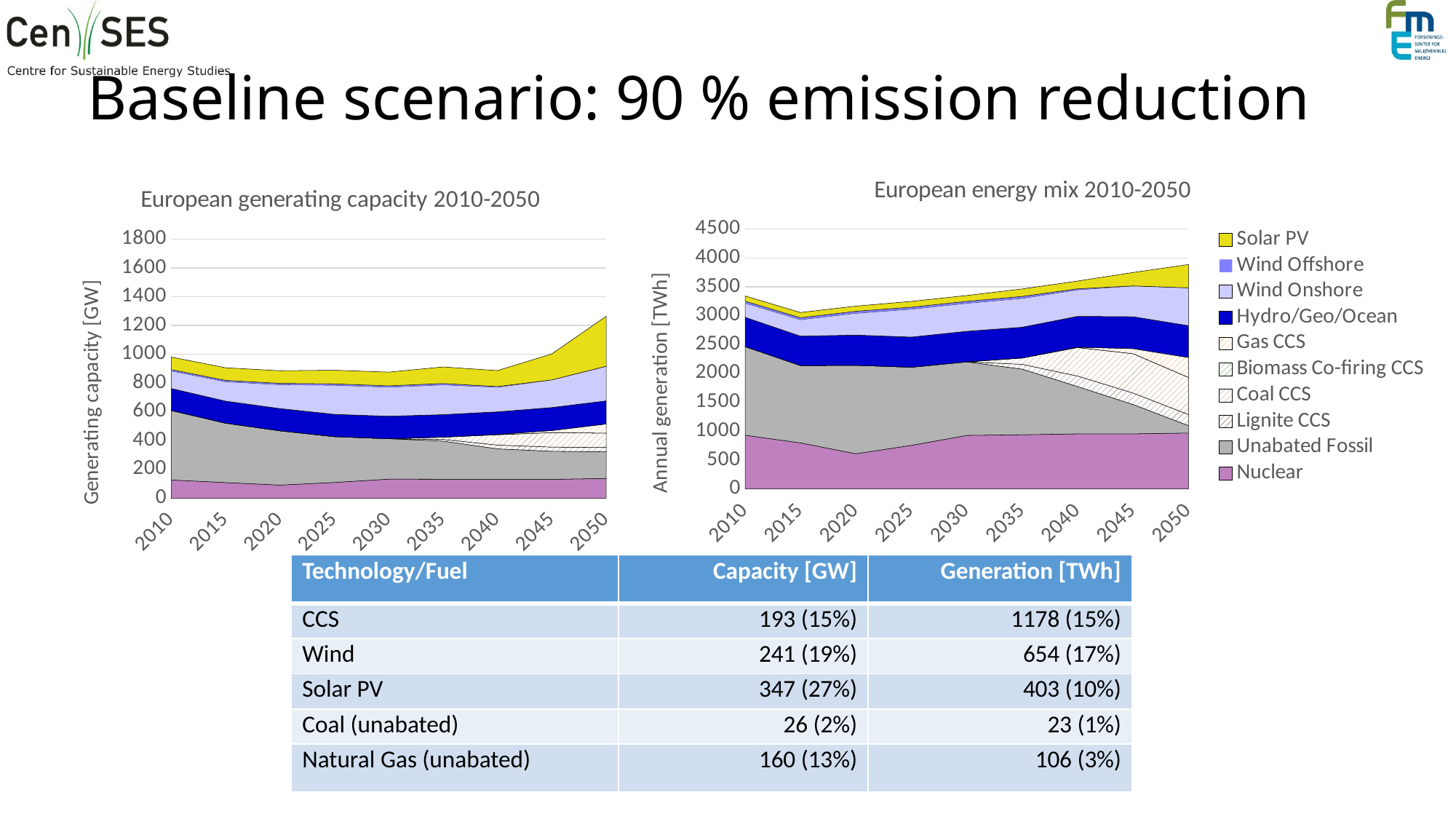
What kind of chart is the 'European generating capacity 2010-2050' chart? Stacked area chart In the 'European energy mix 2010-2050' chart, is the Nuclear generation in 2020 greater or less than 1000 TWh? less In the 'European generating capacity 2010-2050' chart, is the total capacity in 2050 greater or less than 1000 GW? greater Which colour represents Solar PV in the legend? Yellow In the 'European energy mix 2010-2050' chart, does the Unabated Fossil generation rise or fall between 2030 and 2050? fall In the 'European energy mix 2010-2050' chart, is the total annual generation in 2010 greater or less than 3000 TWh? greater How many years are marked on the x axis of the 'European energy mix 2010-2050' chart? 9 What is the y-axis label of the 'European energy mix 2010-2050' chart? Annual generation [TWh] In the 'European generating capacity 2010-2050' chart, does the total capacity rise or fall between 2040 and 2050? rise How many series does the legend on the slide list? 10